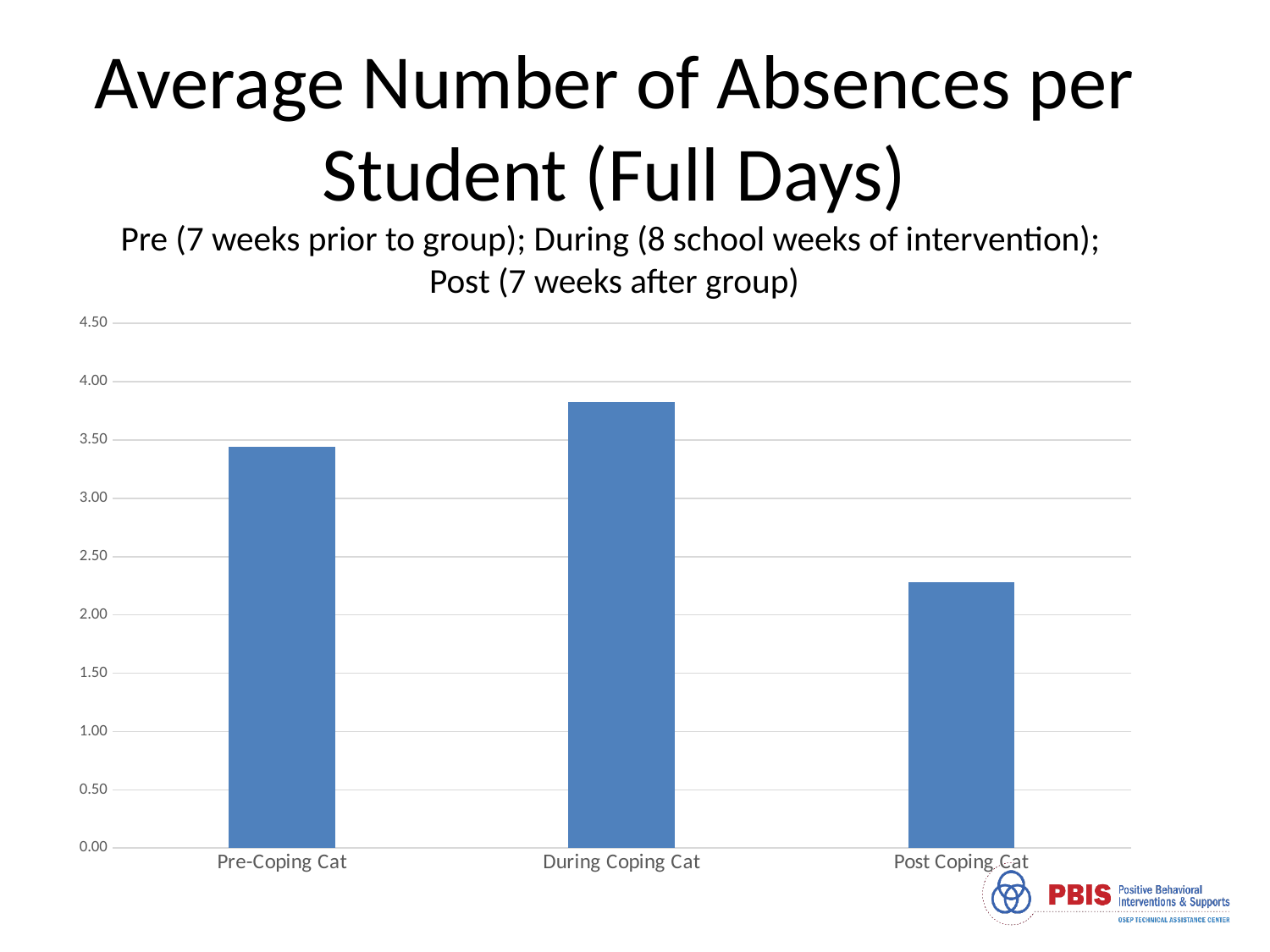
How many categories are shown on the x axis? 3 Is the value for Post Coping Cat greater or less than 2.00? greater Is the value for During Coping Cat greater or less than 4.00? less What is the highest value labelled on the y axis? 4.50 Which is larger, the value for Pre-Coping Cat or the value for Post Coping Cat? Pre-Coping Cat Which category has the highest average number of absences? During Coping Cat Is the value for Pre-Coping Cat greater or less than 3.00? greater Which category has the lowest average number of absences? Post Coping Cat What kind of chart is shown on the slide? bar chart Which is larger, the value for During Coping Cat or the value for Pre-Coping Cat? During Coping Cat What is the title of the chart? Average Number of Absences per Student (Full Days)